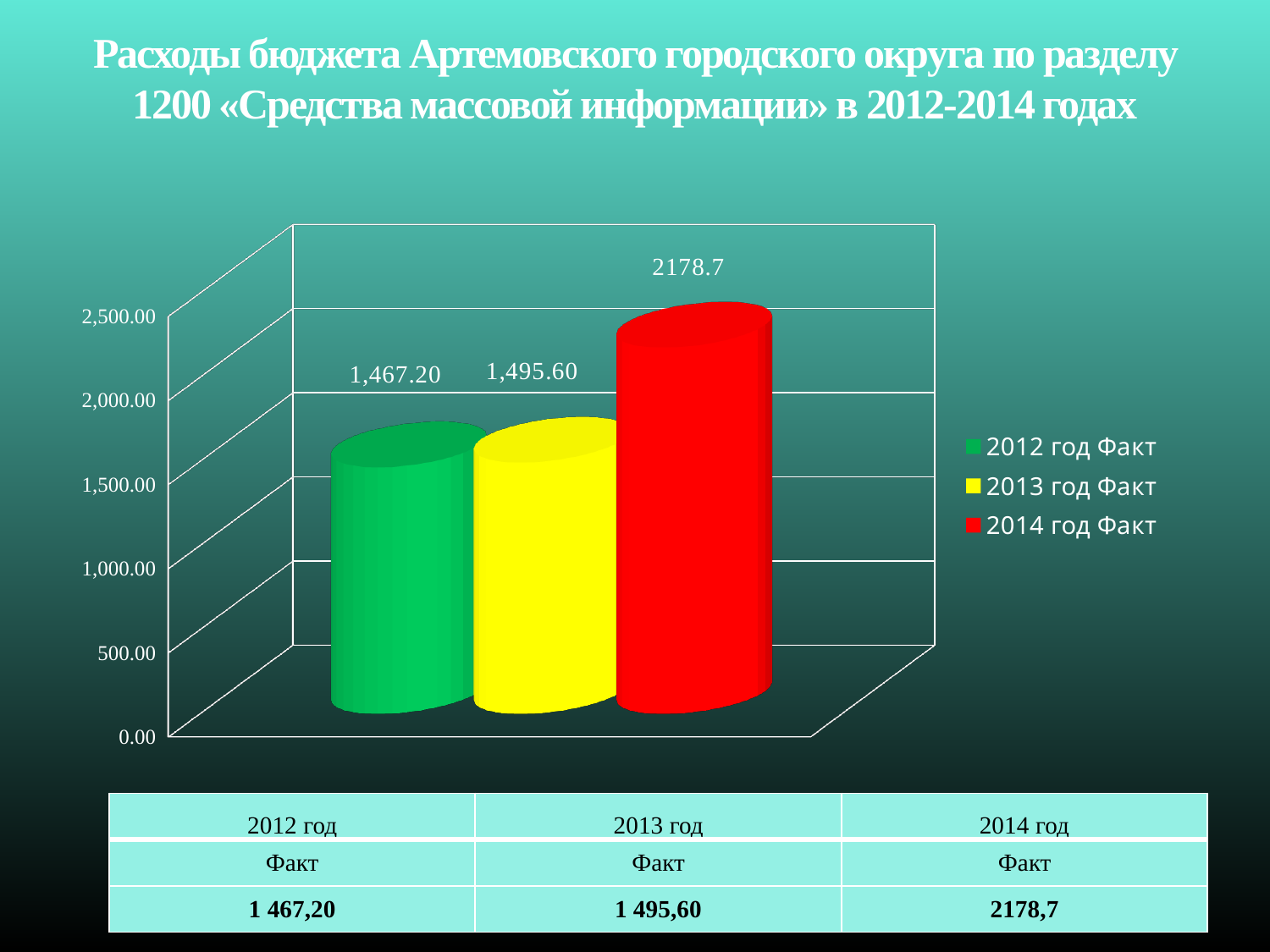
Which year has the lowest value? 2012 год Факт How many series does the legend list? 3 What is the difference between the 2014 год Факт value and the 2013 год Факт value? 683.1 What is the value for 2013 год Факт? 1,495.60 Which year has the highest value? 2014 год Факт Is the value for 2014 год Факт greater or less than 2,000.00? greater What kind of chart is shown on the slide? bar chart What is the difference between the 2013 год Факт value and the 2012 год Факт value? 28.40 What is the value for 2014 год Факт? 2178.7 What is the value for 2012 год Факт? 1,467.20 How many bars are plotted in the chart? 3 Which is larger, the value for 2012 год Факт or the value for 2013 год Факт? 2013 год Факт